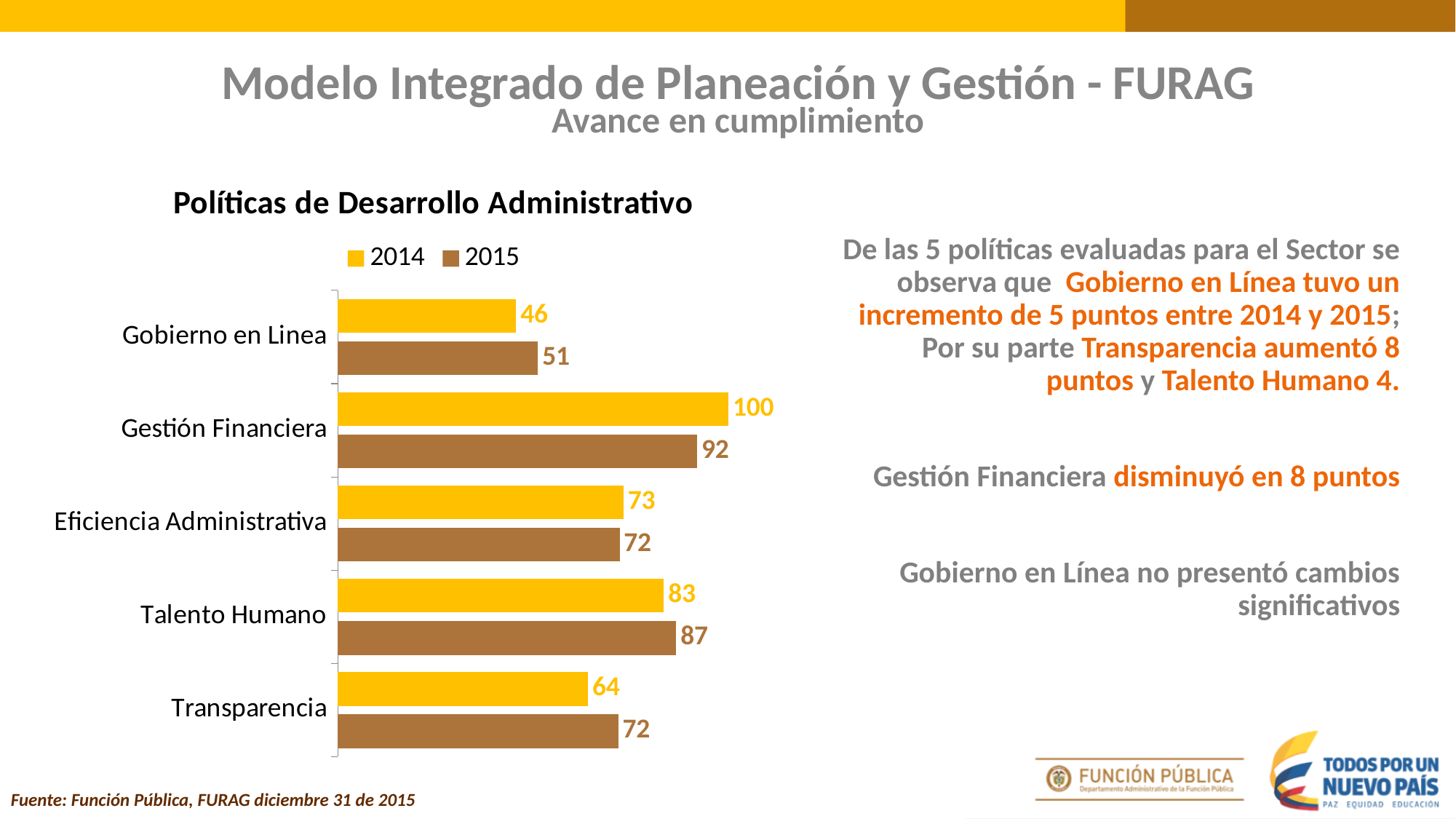
Which category has the highest 2014 value? Gestión Financiera How many series does the legend list? 2 What is the difference between the 2014 and 2015 values for Talento Humano? 4 What is the title of the chart? Políticas de Desarrollo Administrativo Which category has the lowest 2015 value? Gobierno en Linea How many categories are shown in the chart? 5 What is the 2015 value for Transparencia? 72 Which is larger for Transparencia, the 2014 value or the 2015 value? 2015 What kind of chart is shown on the slide? Bar chart What is the 2015 value for Gestión Financiera? 92 What is the difference between the 2014 and 2015 values for Gestión Financiera? 8 What is the 2014 value for Gobierno en Linea? 46